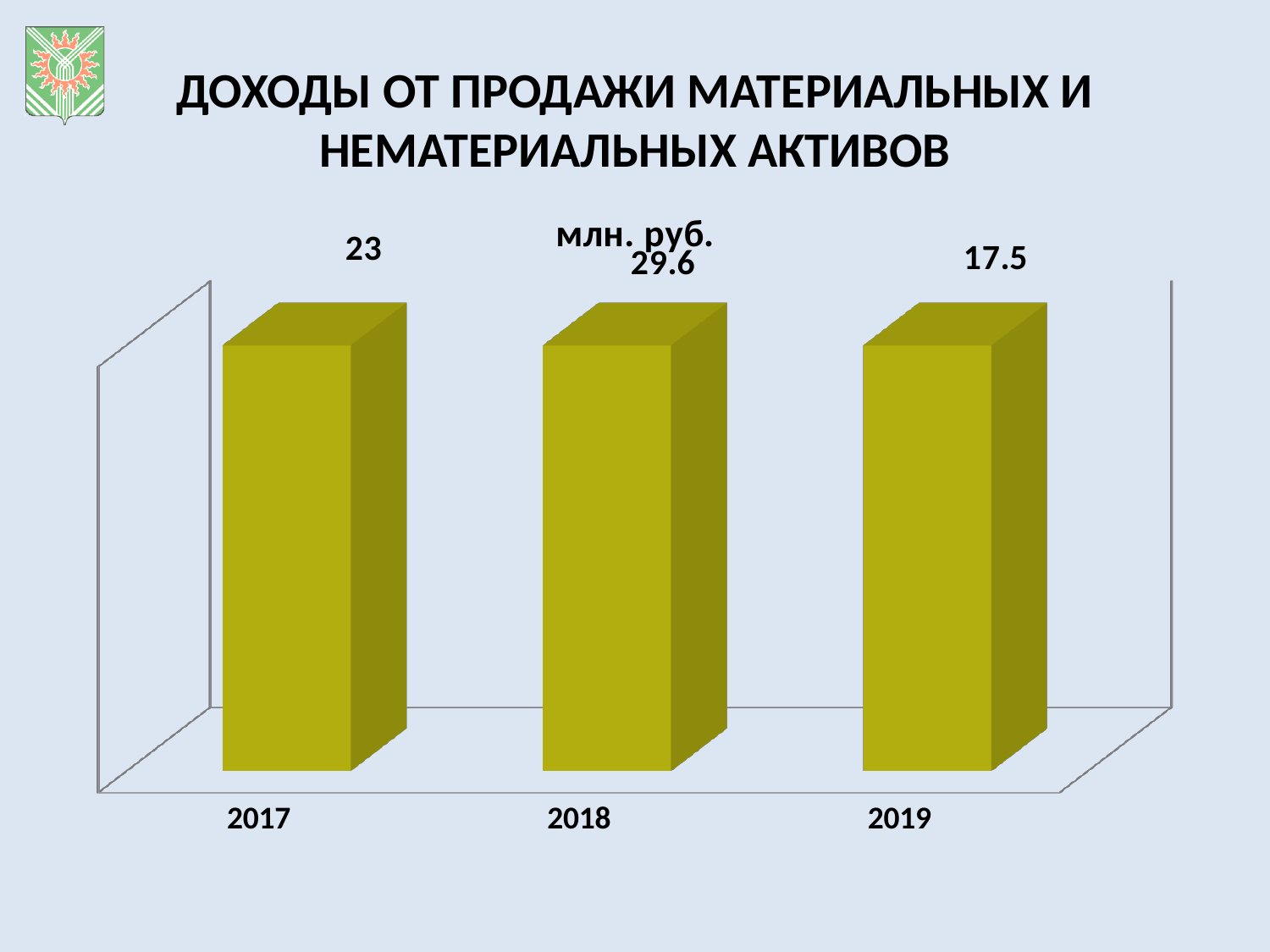
What is the value for 2019? 17.5 What unit is indicated above the chart? млн. руб. What is the difference between the values for 2018 and 2017? 6.6 What is the value for 2017? 23 Do the values rise or fall from 2018 to 2019? fall Which is larger, the value for 2018 or the value for 2019? 2018 What is the value for 2018? 29.6 What is the difference between the values for 2017 and 2019? 5.5 Which year has the lowest value? 2019 What kind of chart is shown on the slide? bar chart How many years are shown on the chart? 3 Which year has the highest value? 2018